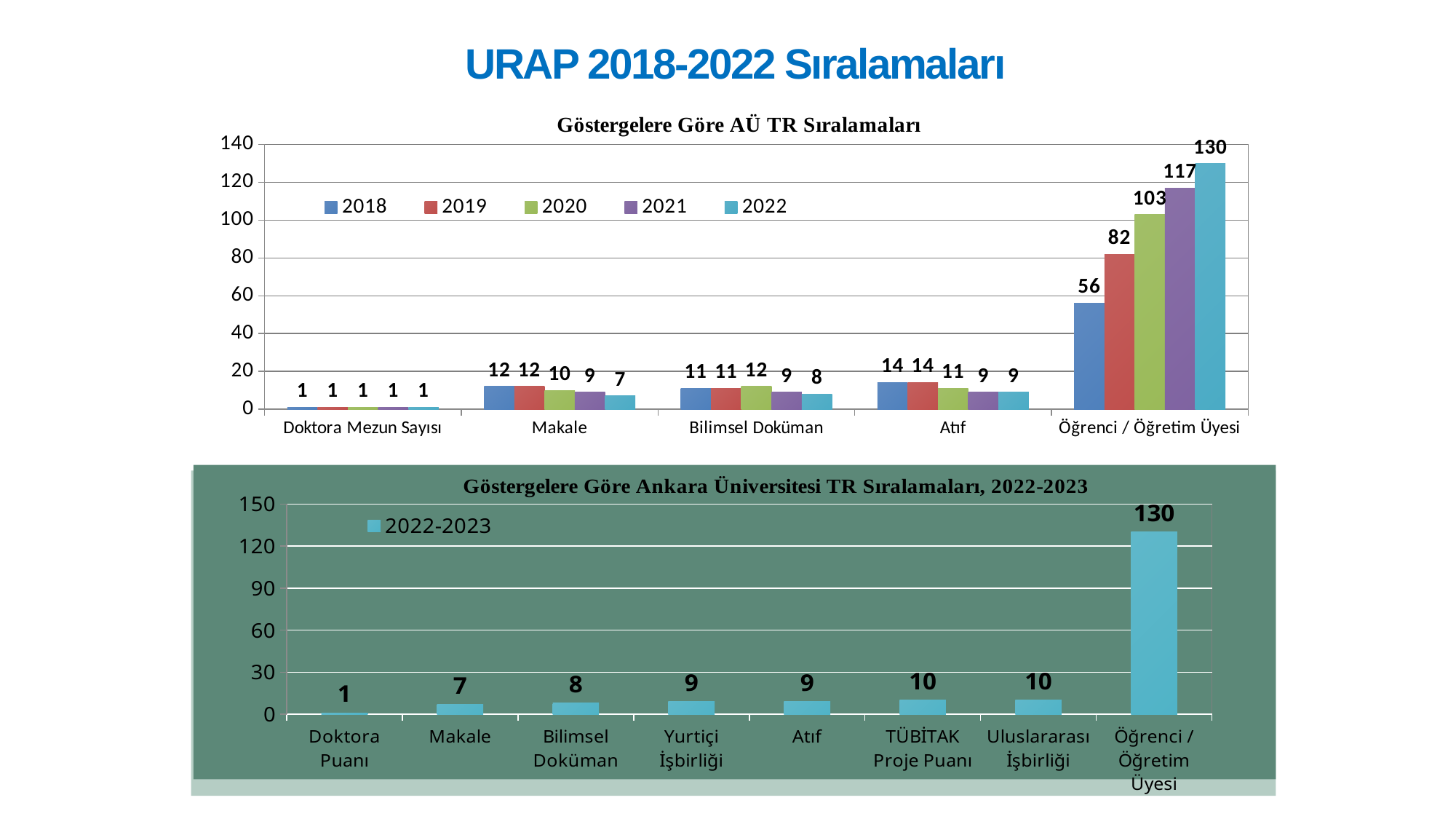
What kind of chart is the bottom chart 'Göstergelere Göre Ankara Üniversitesi TR Sıralamaları, 2022-2023'? bar chart In the bottom chart 'Göstergelere Göre Ankara Üniversitesi TR Sıralamaları, 2022-2023', which category has the highest value? Öğrenci / Öğretim Üyesi In the top chart 'Göstergelere Göre AÜ TR Sıralamaları', how many series does the legend list? 5 In the top chart 'Göstergelere Göre AÜ TR Sıralamaları', which is larger for 2020: Bilimsel Doküman or Makale? Bilimsel Doküman In the bottom chart 'Göstergelere Göre Ankara Üniversitesi TR Sıralamaları, 2022-2023', what is the value for TÜBİTAK Proje Puanı? 10 In the top chart 'Göstergelere Göre AÜ TR Sıralamaları', what is the value for Makale in 2022? 7 In the bottom chart 'Göstergelere Göre Ankara Üniversitesi TR Sıralamaları, 2022-2023', how many categories are shown on the x axis? 8 In the top chart 'Göstergelere Göre AÜ TR Sıralamaları', what is the value for Atıf in 2018? 14 In the bottom chart 'Göstergelere Göre Ankara Üniversitesi TR Sıralamaları, 2022-2023', which category has the lowest value? Doktora Puanı In the top chart 'Göstergelere Göre AÜ TR Sıralamaları', do the values for Öğrenci / Öğretim Üyesi rise or fall from 2018 to 2022? rise In the top chart 'Göstergelere Göre AÜ TR Sıralamaları', what is the value for Öğrenci / Öğretim Üyesi in 2022? 130 In the top chart 'Göstergelere Göre AÜ TR Sıralamaları', what is the difference between the 2022 and 2018 values for Öğrenci / Öğretim Üyesi? 74